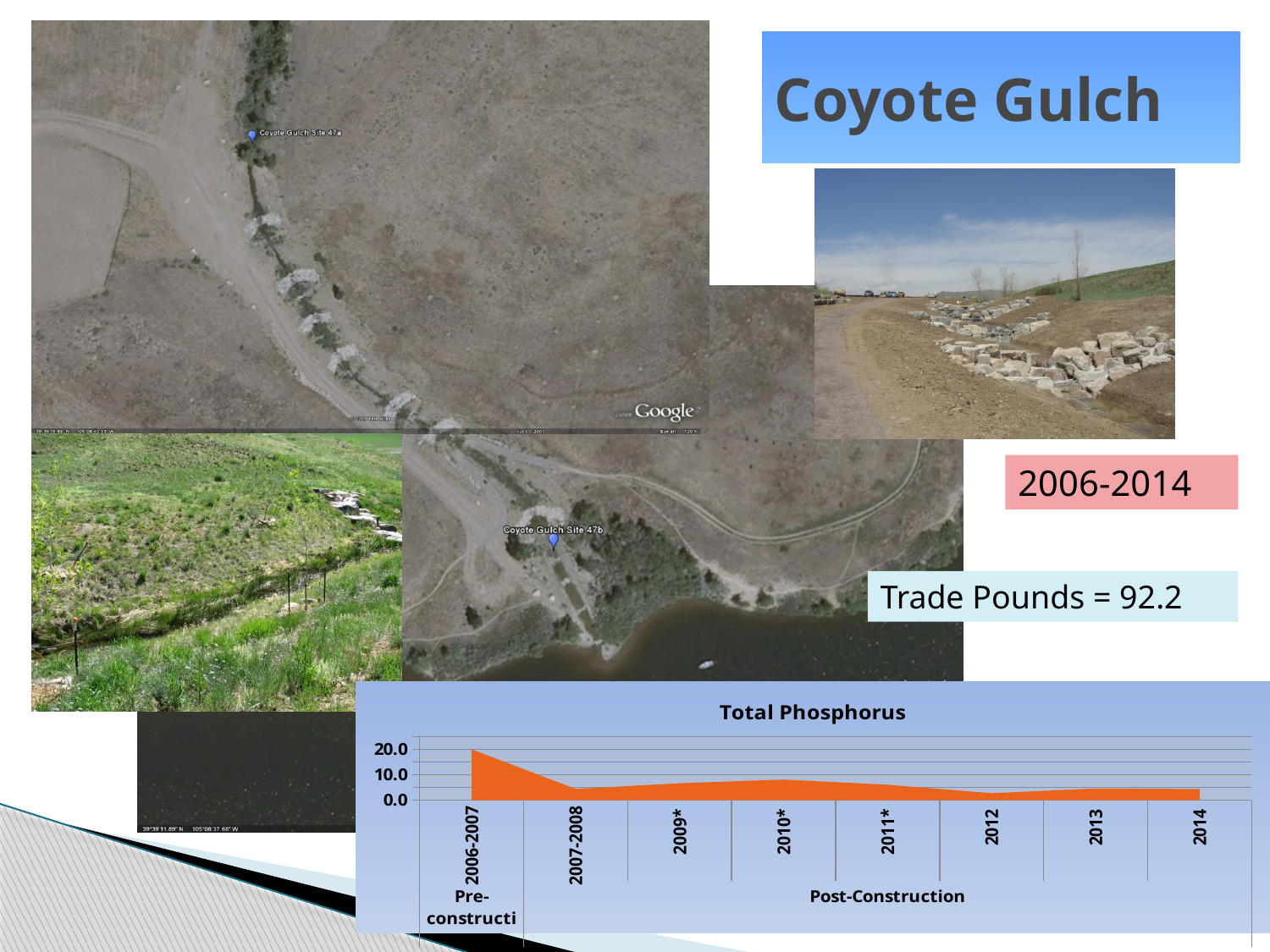
Is the Total Phosphorus value for 2006-2007 greater or less than 10.0? greater Is the Total Phosphorus value for 2007-2008 greater or less than 10.0? less How many time periods are shown along the x axis of the Total Phosphorus chart? 8 Which has the larger Total Phosphorus value, 2006-2007 or 2010*? 2006-2007 What kind of chart is the Total Phosphorus chart? area chart Which period has the highest Total Phosphorus value? 2006-2007 Overall, do Total Phosphorus values rise or fall from 2006-2007 to 2014? fall What is the title of the chart on the slide? Total Phosphorus Is the Total Phosphorus value for 2012 greater or less than 10.0? less Which period on the Total Phosphorus chart is labelled as Pre-construction? 2006-2007 Which has the larger Total Phosphorus value, 2010* or 2012? 2010*